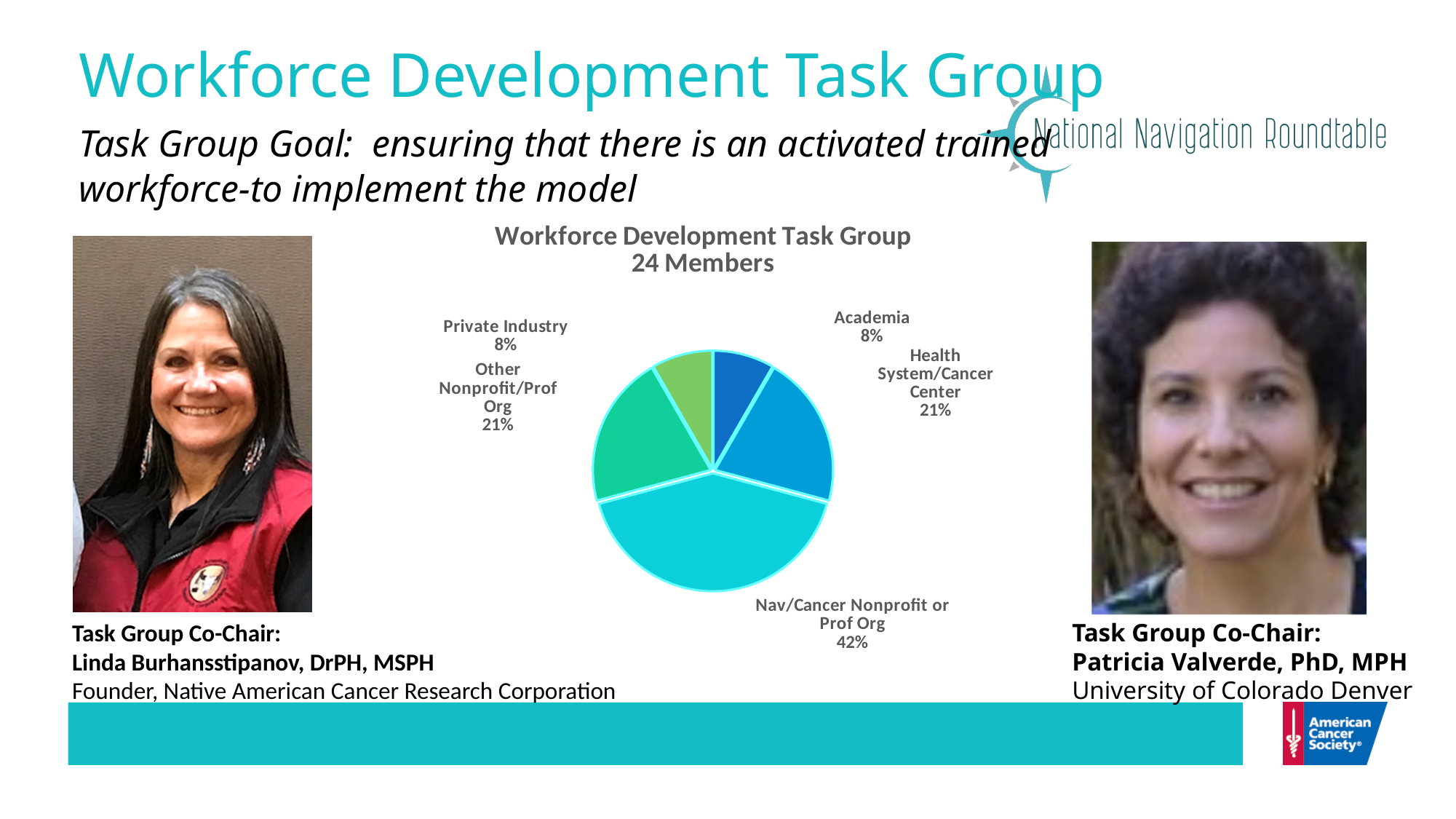
What is the title of the chart? Workforce Development Task Group 24 Members What share of the pie does Health System/Cancer Center represent? 21% What type of chart is shown on the slide? pie chart What is the difference in percentage points between Nav/Cancer Nonprofit or Prof Org and Health System/Cancer Center? 21 What share of the pie does Other Nonprofit/Prof Org represent? 21% Which is larger, the share for Other Nonprofit/Prof Org or the share for Private Industry? Other Nonprofit/Prof Org What share of the pie does Private Industry represent? 8% How many members does the chart title say the task group has? 24 Which category has the largest slice of the pie? Nav/Cancer Nonprofit or Prof Org How many categories are shown in the pie chart? 5